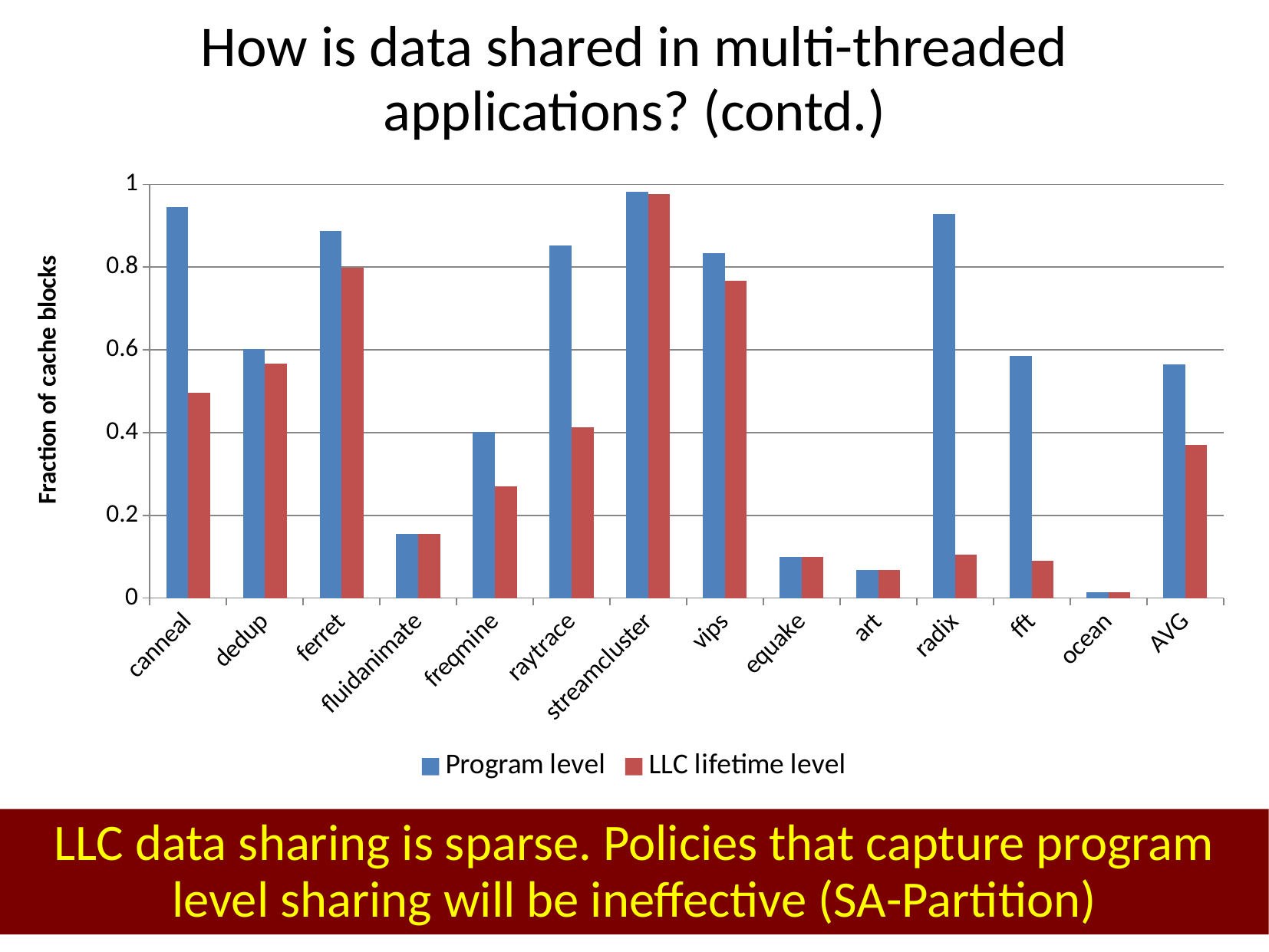
Which category has the highest LLC lifetime level value? streamcluster What is the label of the y axis? Fraction of cache blocks What kind of chart is shown on the slide? bar chart Is the Program level value for canneal greater or less than 0.8? greater How many series does the legend list? 2 How many categories are shown on the x axis? 14 Is the LLC lifetime level value for freqmine greater or less than 0.4? less Which has a larger Program level value, canneal or dedup? canneal Is the LLC lifetime level value for radix greater or less than 0.2? less For radix, which is larger: the Program level value or the LLC lifetime level value? Program level Which category has the lowest Program level value? ocean